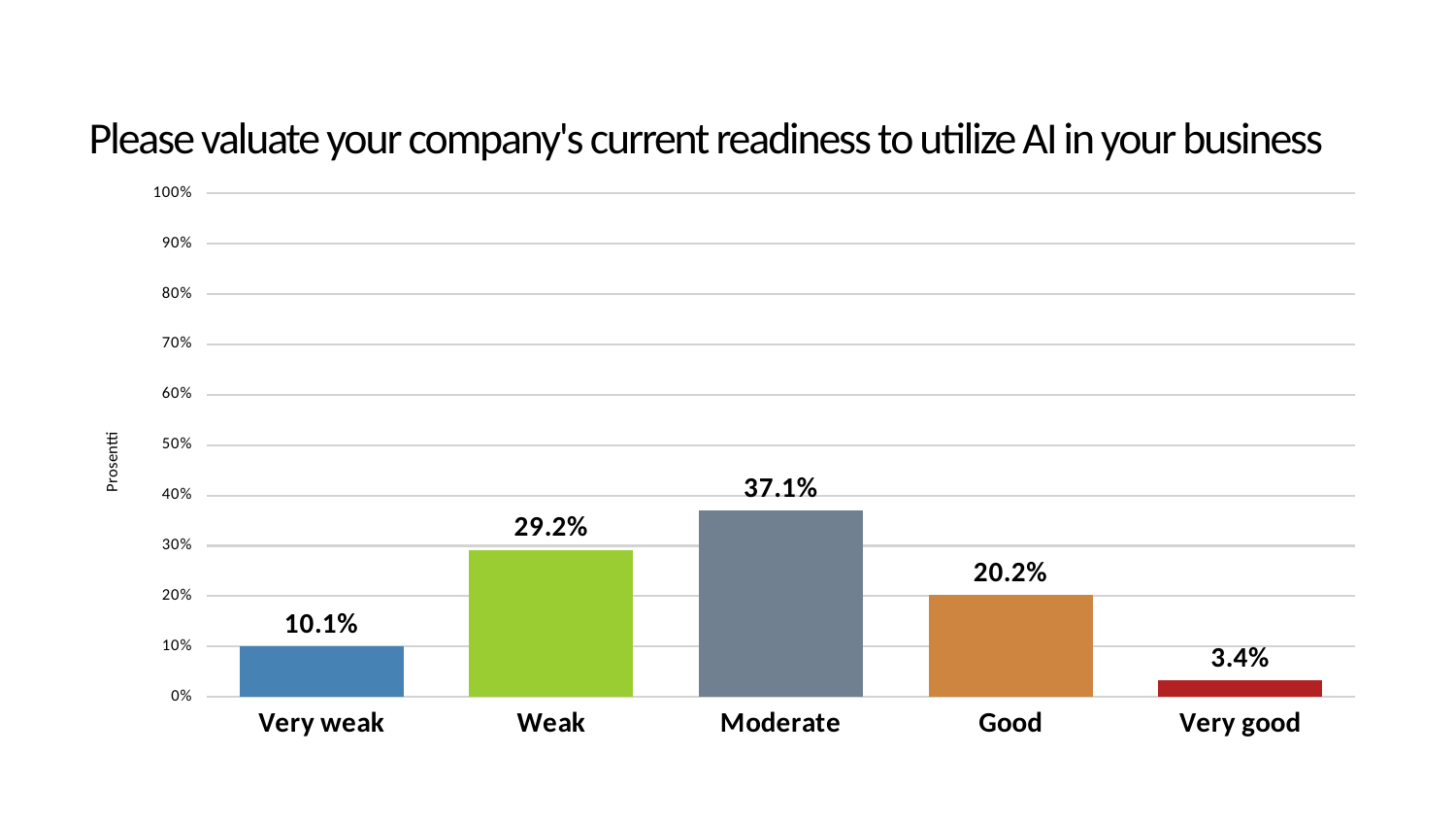
What kind of chart is shown on the slide? Bar chart What is the value shown for the Very good category? 3.4% Which is larger, the value for Weak or the value for Good? Weak Is the value for Good greater or less than 30%? less What percentage of respondents rated their company's AI readiness as Moderate? 37.1% What is the difference between the Very weak and Very good values? 6.7% Which category has the highest value? Moderate What is the value shown for the Weak category? 29.2% What is the difference between the Moderate and Good values? 16.9% Which category has the lowest value? Very good What is the label on the vertical axis? Prosentti How many categories are shown on the x axis? 5